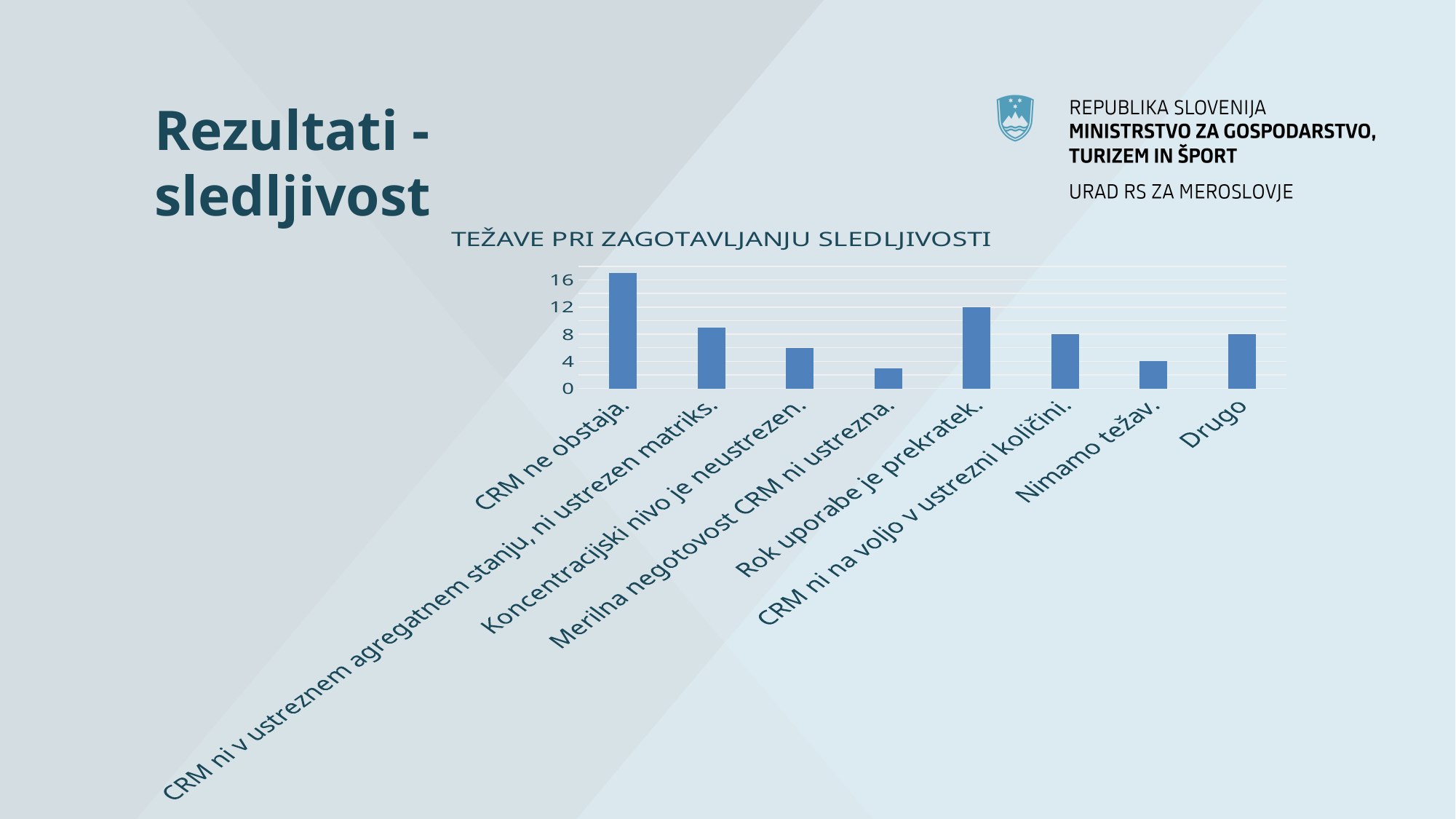
Which category has the highest value in the chart? CRM ne obstaja. Which is larger, the value for "Rok uporabe je prekratek." or the value for "Drugo"? Rok uporabe je prekratek. What kind of chart is shown on the slide? bar chart Is the value for "Merilna negotovost CRM ni ustrezna." greater or less than 4? less What is the value for "Rok uporabe je prekratek."? 12 Is the value for "CRM ne obstaja." greater or less than 16? greater Is the value for "Koncentracijski nivo je neustrezen." greater or less than 4? greater How many categories are shown on the x axis of the chart? 8 Which category has the lowest value in the chart? Merilna negotovost CRM ni ustrezna. What is the title of the chart? TEŽAVE PRI ZAGOTAVLJANJU SLEDLJIVOSTI Which is larger, the value for "CRM ni v ustreznem agregatnem stanju, ni ustrezen matriks." or the value for "Nimamo težav."? CRM ni v ustreznem agregatnem stanju, ni ustrezen matriks. What is the value for "Nimamo težav."? 4